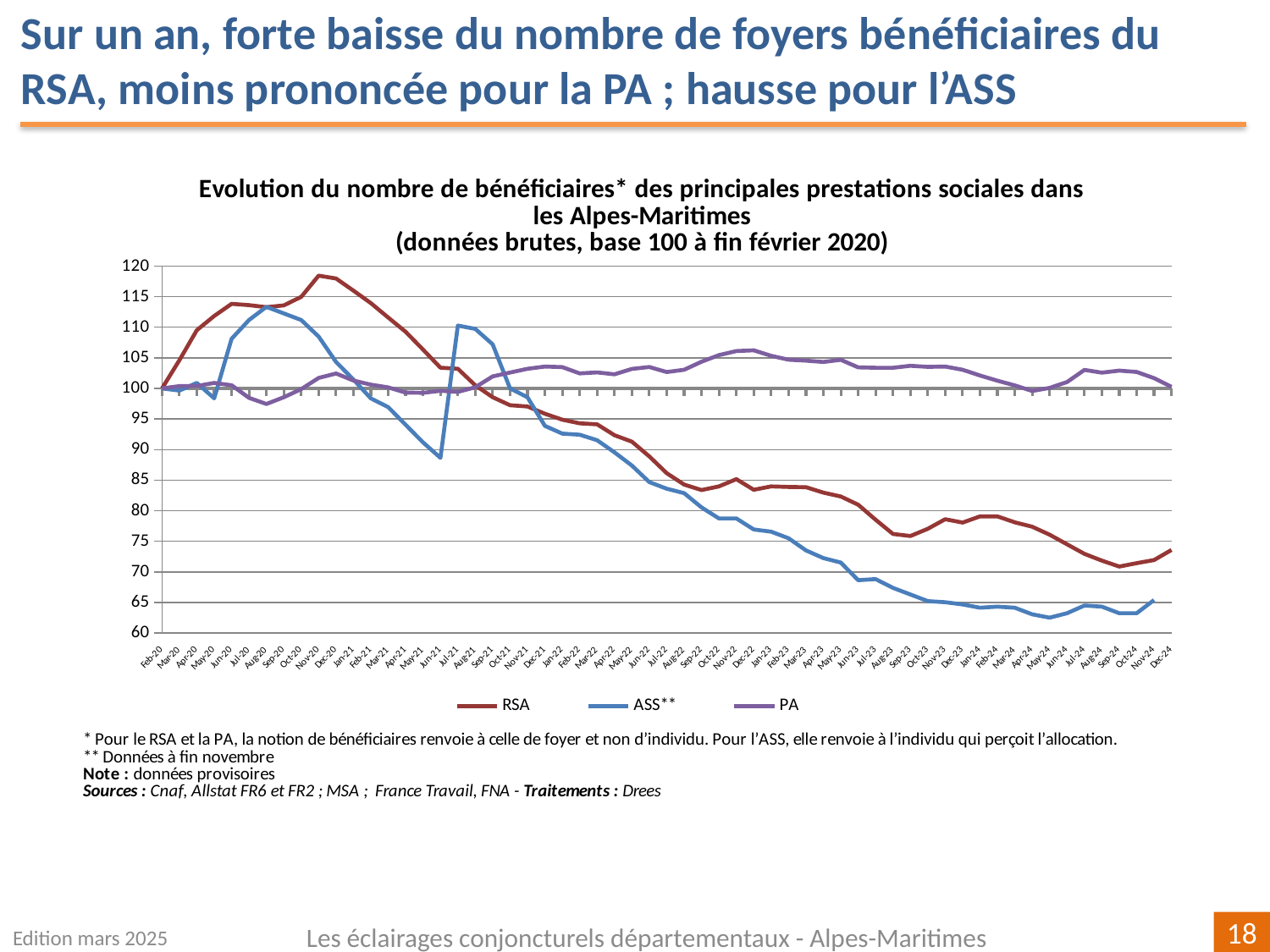
Which series has the highest value at Dec-24? PA What kind of chart is shown on the slide? Line chart How many series does the legend list? 3 Is the peak value of the RSA series (around Nov-20) greater or less than 115? greater Is the value for RSA at Dec-24 greater or less than 75? less What is the value of the RSA series at Feb-20? 100 Does the RSA series rise or fall between Nov-20 and Dec-24? Fall Is the value for ASS** at Jun-21 greater or less than 90? less Which series are listed in the legend? RSA, ASS**, PA